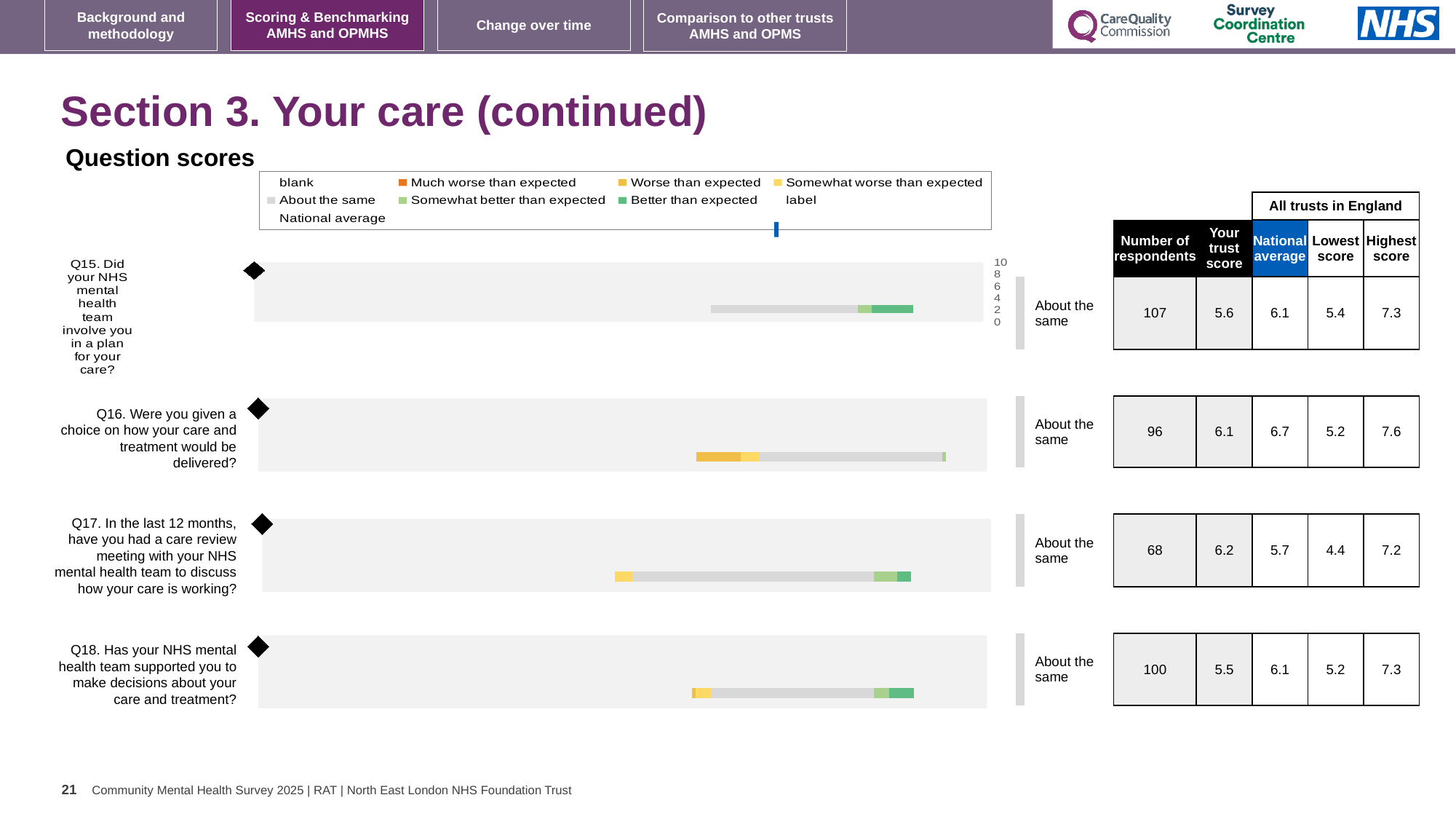
What colour does the legend use for 'Better than expected'? Green What is the trust score for Q16 (Were you given a choice on how your care and treatment would be delivered?)? 6.1 What is the national average for Q17 (care review meeting in the last 12 months)? 5.7 What is the highest score among all trusts in England for Q18 (supported you to make decisions about your care and treatment)? 7.3 For Q17, which is larger: the trust score or the national average? The trust score How many questions (Q15 to Q18) have a score bar on this slide? 4 What comparison label is shown next to the bar for Q18? About the same Which question has the highest number of respondents? Q15 What kind of chart is used to show the question scores for Q15 to Q18? Bar chart For Q16, how much higher is the national average than the trust score? 0.6 Which question has the lowest 'Lowest score' among all trusts in England? Q17 What is the number of respondents for Q15 (Did your NHS mental health team involve you in a plan for your care?)? 107